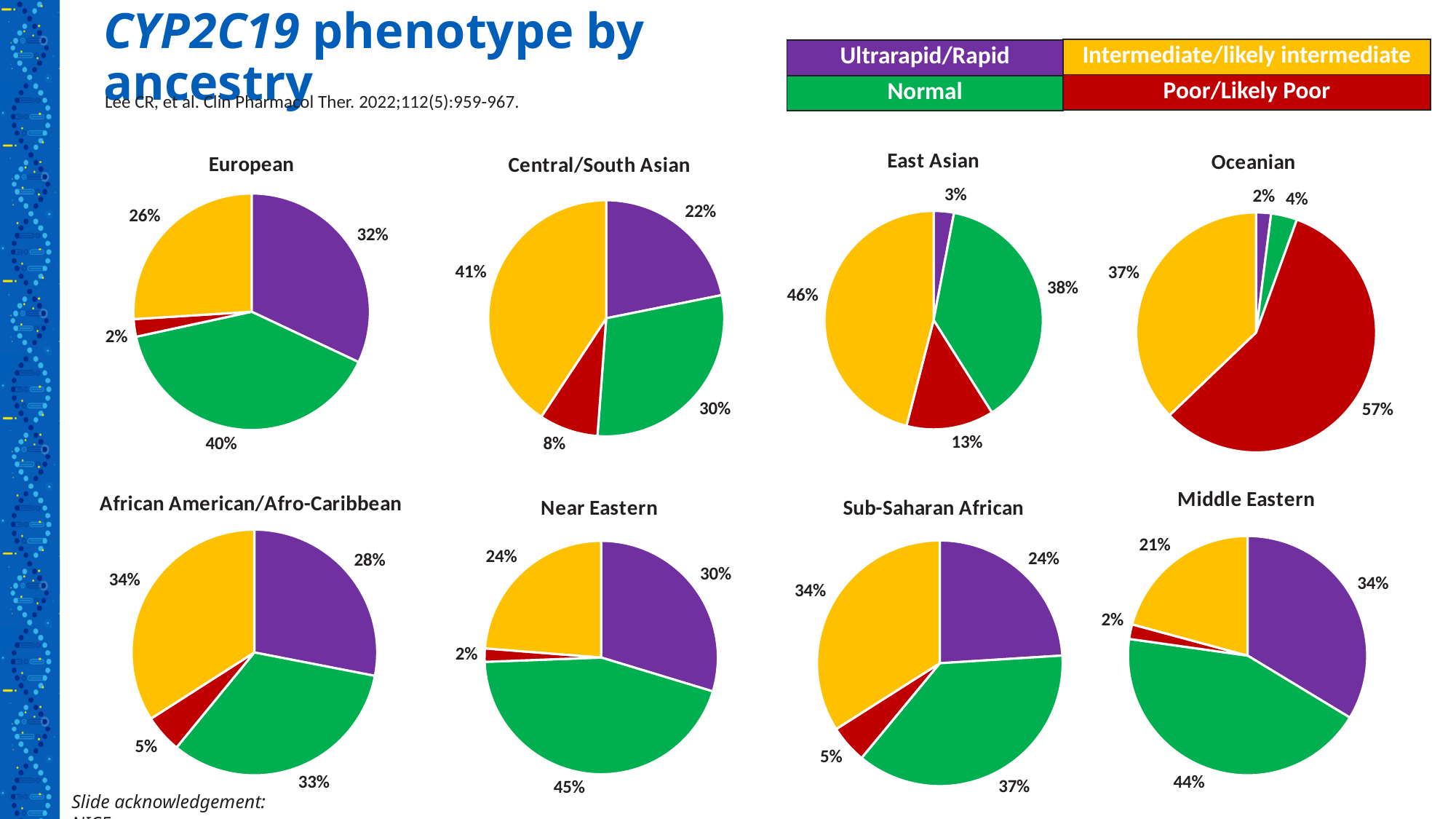
In the Near Eastern pie chart, which phenotype has the smallest slice? Poor/Likely Poor In the Middle Eastern pie chart, which phenotype has the largest slice? Normal How many phenotype categories does the legend list? 4 In the East Asian pie chart, what share is Ultrarapid/Rapid? 3% What type of chart is used for each ancestry group on the slide? Pie chart In the African American/Afro-Caribbean pie chart, which is larger: the Intermediate/likely intermediate share or the Normal share? Intermediate/likely intermediate How many pie charts are shown on the slide? 8 In the Central/South Asian pie chart, what share is Intermediate/likely intermediate? 41% In the Oceanian pie chart, what share is Poor/Likely Poor? 57% In the Sub-Saharan African pie chart, what is the difference between the Normal share and the Ultrarapid/Rapid share? 13% In the European pie chart, what share is Normal? 40% According to the legend, which colour represents Poor/Likely Poor? Red